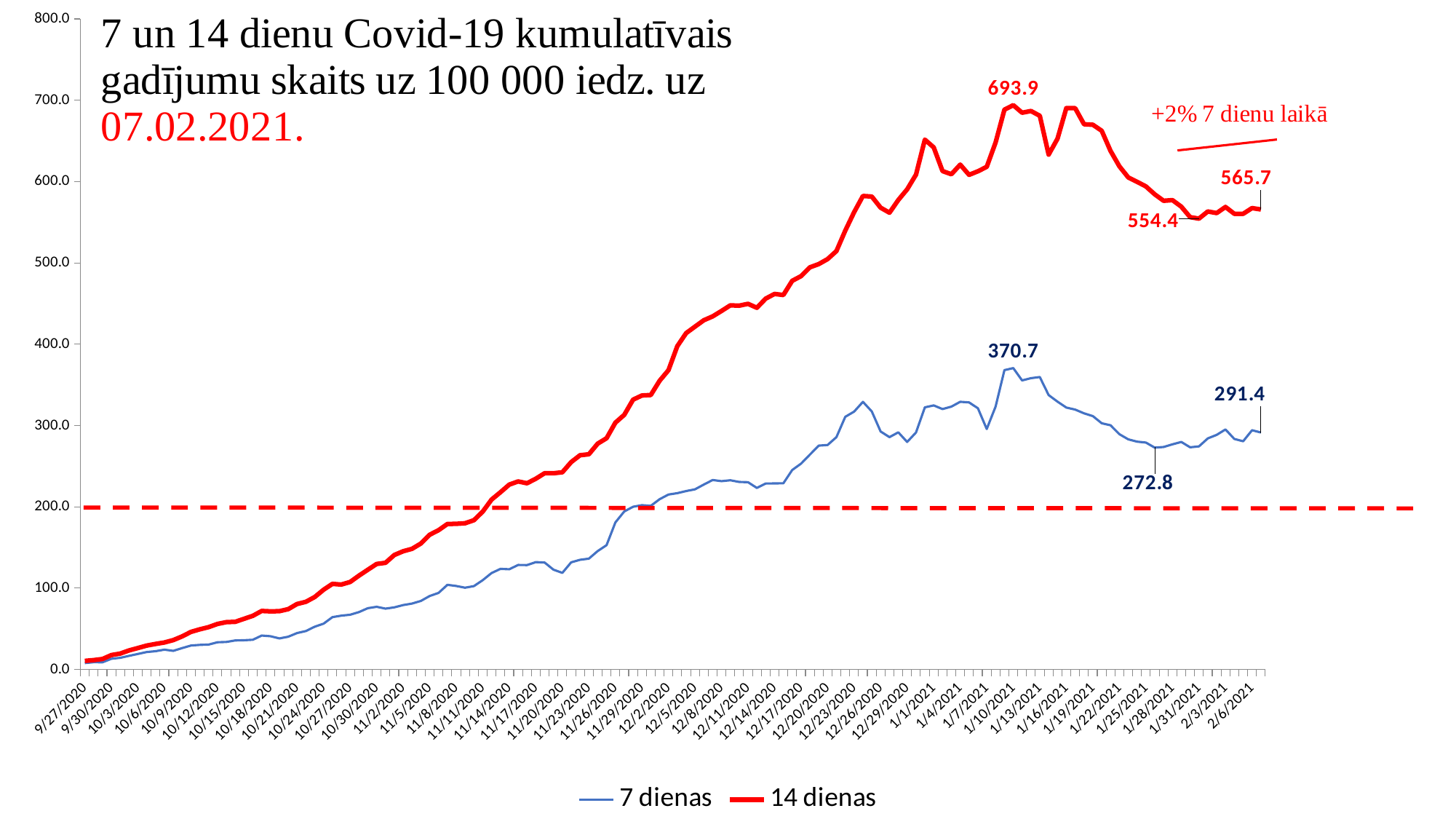
What is the last labelled value of the 14 dienas line, at 2/6/2021? 565.7 Is the value of the 7 dienas line on 10/27/2020 greater or less than 100? less How many series does the legend list? 2 What is the difference between the 7 dienas peak of 370.7 and the labelled value 272.8? 97.9 At what level on the y axis is the horizontal red dashed line drawn? 200.0 What kind of chart is shown on the slide? line chart Does the 14 dienas line rise or fall between 9/27/2020 and 1/10/2021? rise What is the last labelled value of the 7 dienas line, at 2/6/2021? 291.4 What is the difference between the 14 dienas peak of 693.9 and its final value of 565.7? 128.2 What is the peak value labelled on the 14 dienas line? 693.9 What is the peak value labelled on the 7 dienas line? 370.7 Which series has the higher value at 2/6/2021, 7 dienas or 14 dienas? 14 dienas